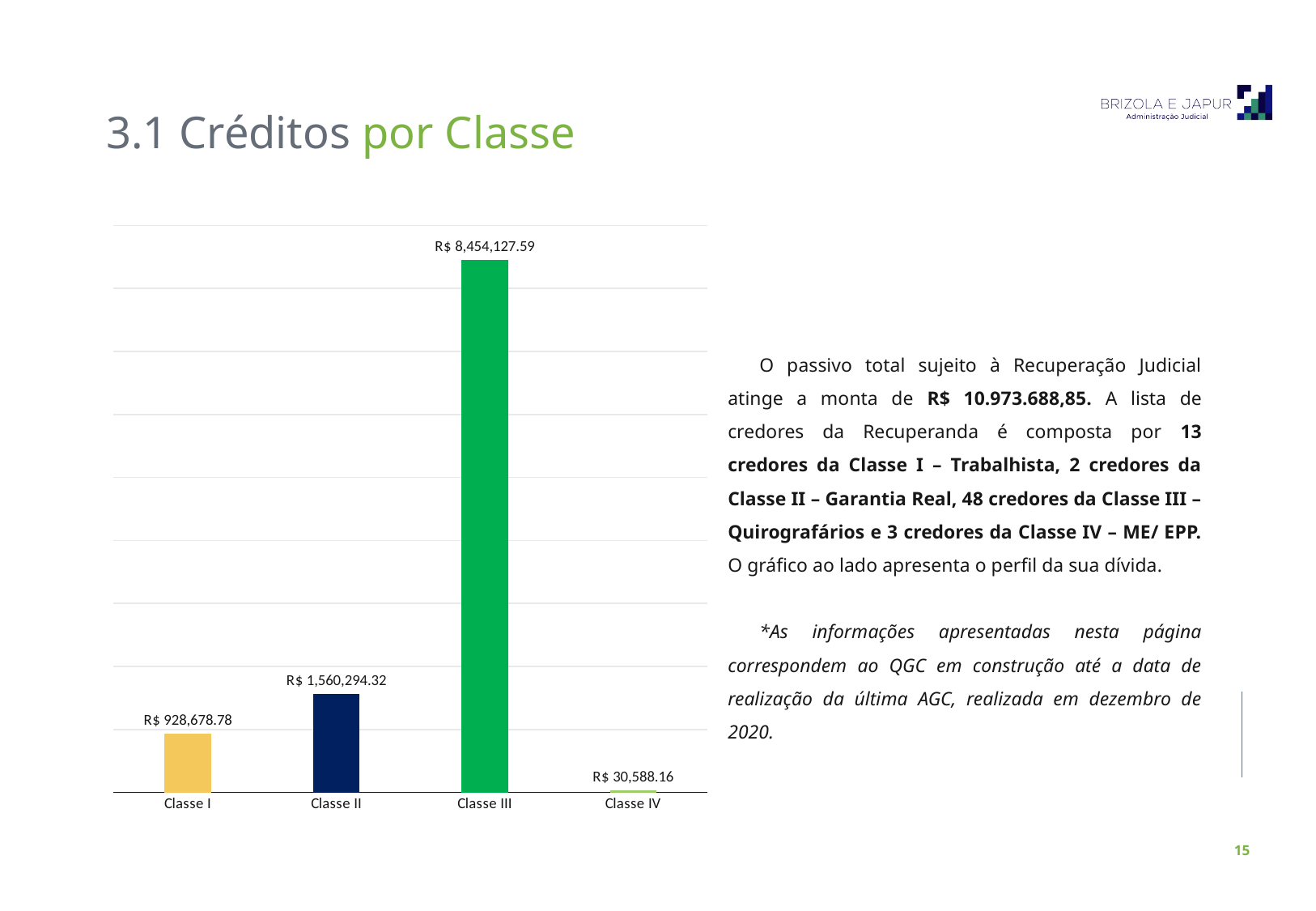
What is the value for Classe III? R$ 8,454,127.59 Which class has the highest value? Classe III What is the value for Classe IV? R$ 30,588.16 How many classes are shown on the chart? 4 Which is larger, the value for Classe I or the value for Classe II? Classe II What kind of chart is shown on the slide? Bar chart What colour is the bar for Classe III? Green What is the difference between the values for Classe II and Classe I? R$ 631,615.54 What is the value for Classe I? R$ 928,678.78 What is the difference between the values for Classe III and Classe II? R$ 6,893,833.27 What is the value for Classe II? R$ 1,560,294.32 Which class has the lowest value? Classe IV